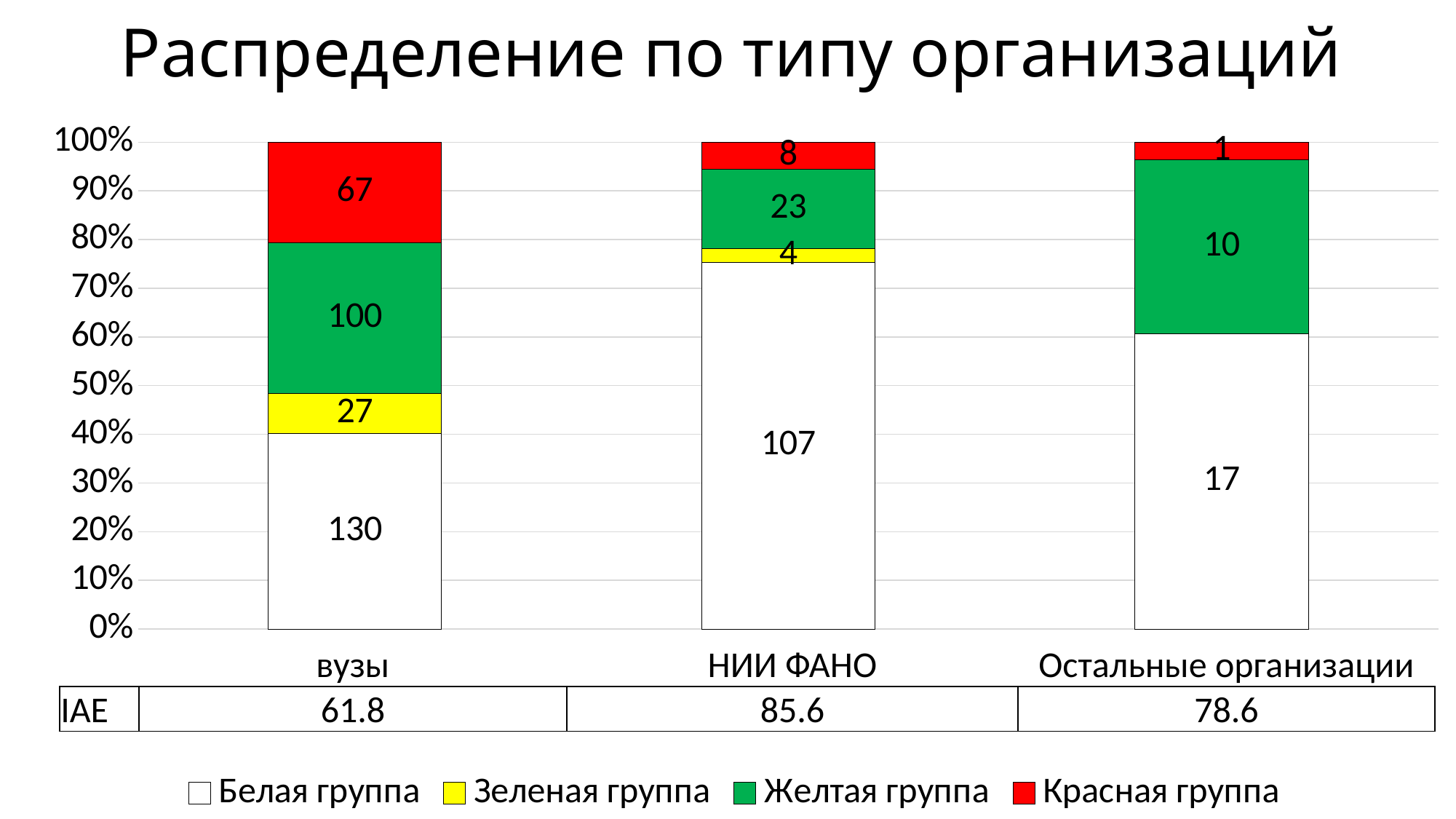
How many series does the legend list? 4 What is the value of the Красная группа segment for НИИ ФАНО? 8 What is the IAE value shown for НИИ ФАНО? 85.6 What is the value of the Красная группа segment for Остальные организации? 1 What kind of chart is shown on the slide? Stacked bar chart Which category has the highest IAE value in the table below the chart? НИИ ФАНО What is the value of the green segment for Остальные организации? 10 What is the value of the Белая группа segment for вузы? 130 How many categories are shown on the x axis? 3 What is the total of all segments in the вузы bar? 324 What is the difference between the Белая группа values for вузы and НИИ ФАНО? 23 Which has a larger Красная группа value, вузы or НИИ ФАНО? вузы